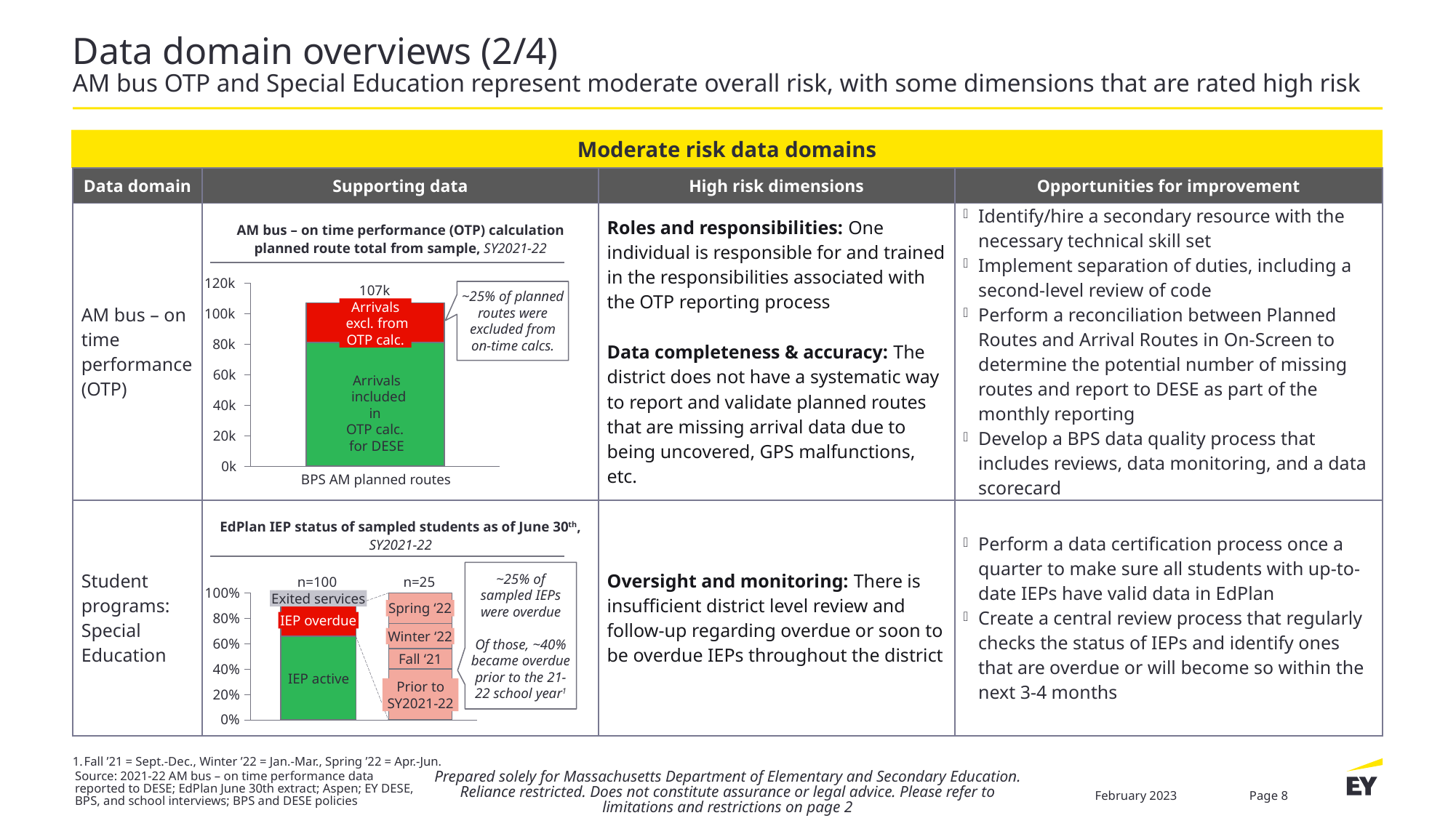
In the EdPlan IEP status chart, what sample size is labelled above the main stacked bar? n=100 In the AM bus OTP chart, is the value for Arrivals included in OTP calc. for DESE greater or less than 60k? greater In the EdPlan IEP status chart, which segment of the n=100 bar is the smallest? Exited services In the EdPlan IEP status chart, which segment of the n=100 bar is the largest? IEP active In the AM bus OTP chart, what is the category label on the x axis? BPS AM planned routes In the AM bus OTP chart, which segment is larger: Arrivals included in OTP calc. for DESE or Arrivals excl. from OTP calc.? Arrivals included in OTP calc. for DESE In the EdPlan IEP status chart, how many segments make up the n=25 breakdown bar? 4 In the EdPlan IEP status chart, what sample size is labelled above the breakdown bar of overdue IEPs? n=25 What kind of chart is shown for the AM bus on time performance (OTP) data domain? bar chart In the AM bus OTP chart, what is the highest tick shown on the y axis? 120k How many bars (categories) are plotted in the AM bus OTP chart? 1 In the AM bus OTP chart, what total value is labelled above the BPS AM planned routes bar? 107k